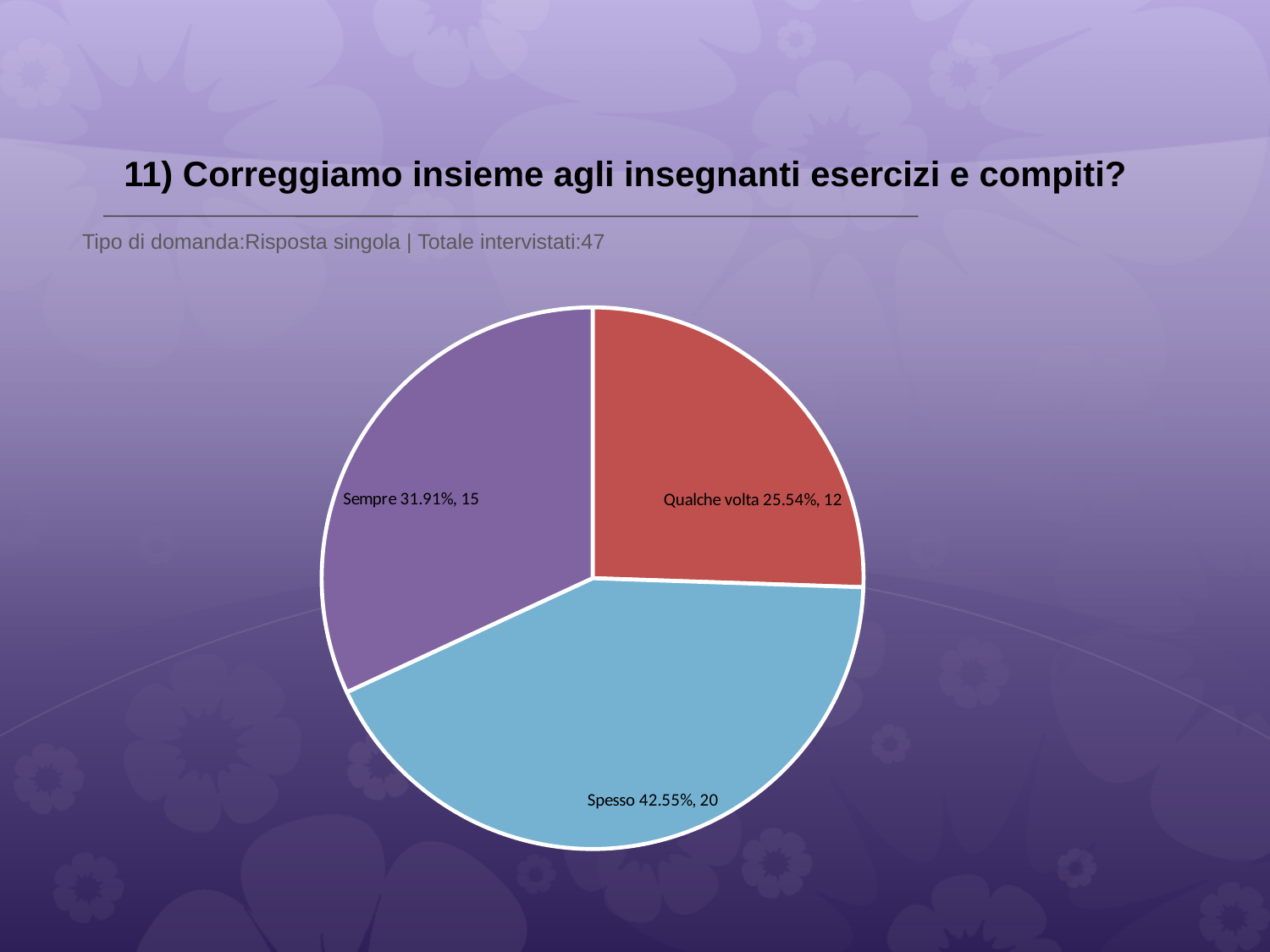
How many respondents answered 'Spesso'? 20 What is the difference in respondent count between 'Spesso' and 'Qualche volta'? 8 What percentage share does the 'Sempre' slice have? 31.91% How many slices does the pie chart have? 3 How many respondents answered 'Sempre'? 15 Which category has the largest slice? Spesso How many respondents answered 'Qualche volta'? 12 What kind of chart is shown on the slide? pie chart What percentage share does the 'Qualche volta' slice have? 25.54% Which category has the smallest slice? Qualche volta Which has more respondents, 'Sempre' or 'Qualche volta'? Sempre What percentage share does the 'Spesso' slice have? 42.55%